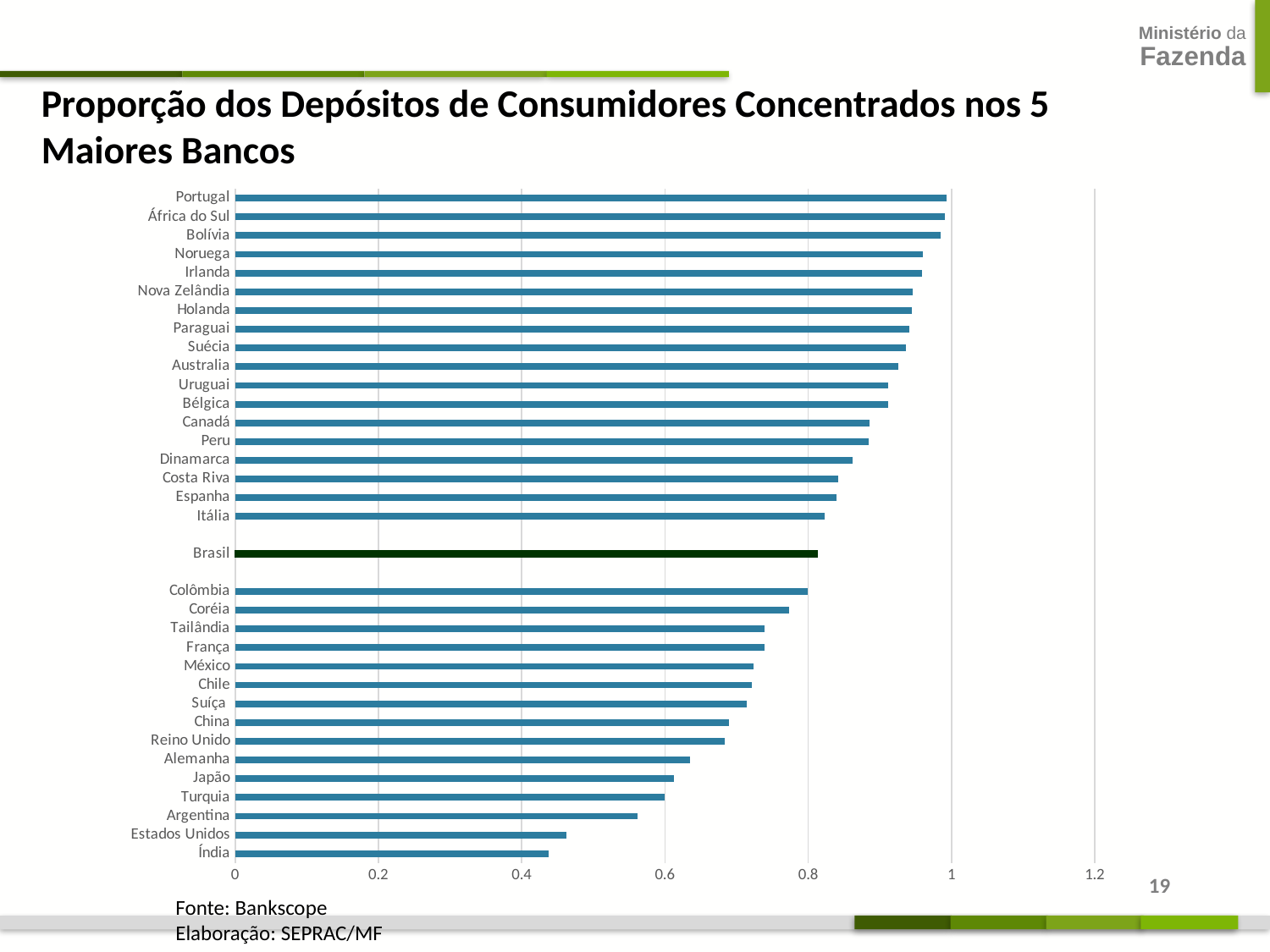
Is the value for China greater or less than 0.8? less Which has a larger value, Alemanha or Argentina? Alemanha Is the value for Estados Unidos greater or less than 0.4? greater Is the value for Portugal greater or less than 0.8? greater Which country has the longest bar on the chart? Portugal What kind of chart is shown on the slide? Bar chart How many countries are listed on the chart? 34 Which country has the shortest bar on the chart? Índia What is the source cited below the chart? Bankscope Which bar is drawn in a different colour from the rest? Brasil